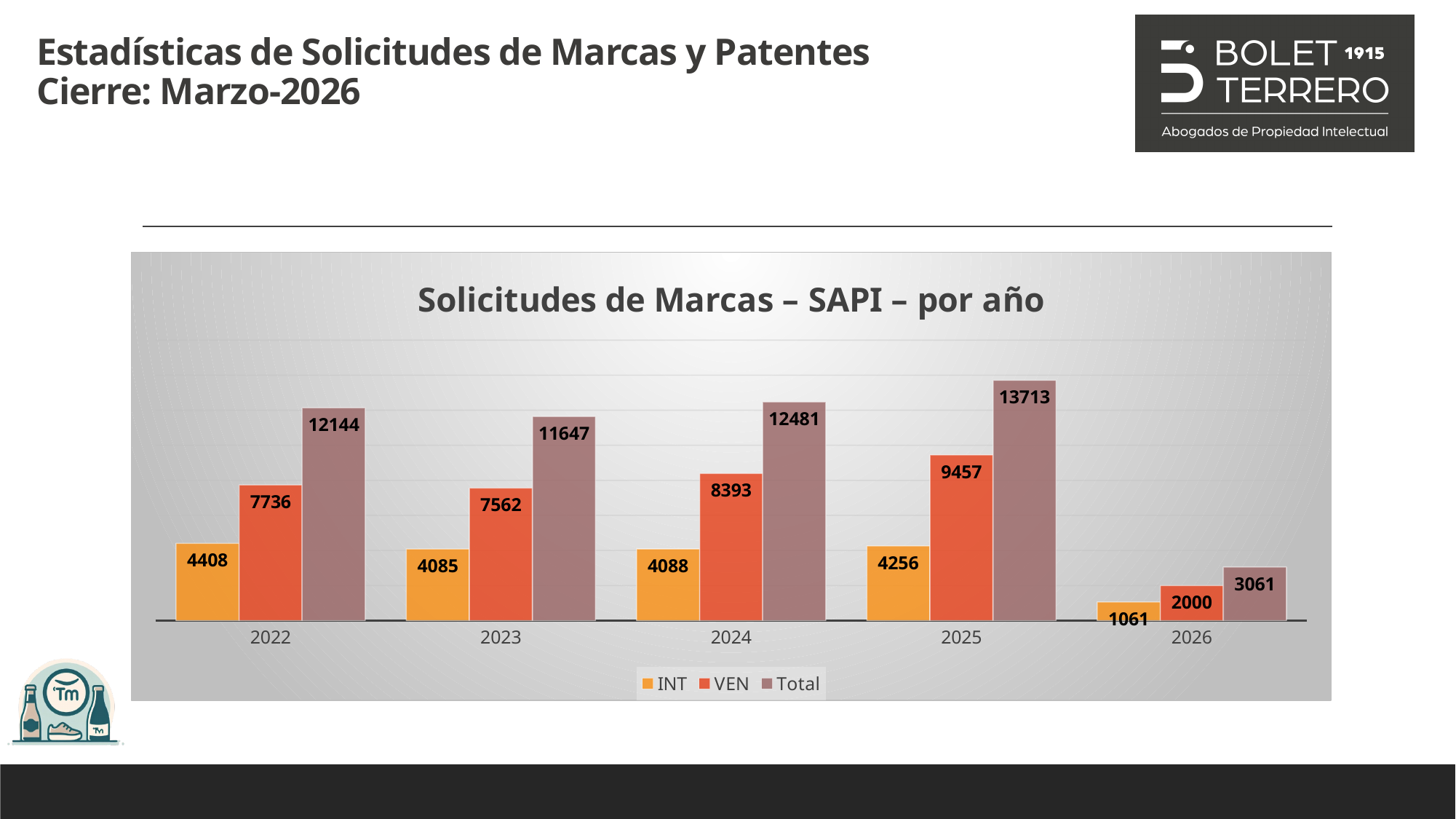
What is the VEN value for 2024? 8393 Which year has the highest Total value? 2025 How many series does the legend list? 3 What is the difference between the VEN values for 2025 and 2024? 1064 What kind of chart is shown on the slide? Bar chart What is the Total value for 2026? 3061 Which year has the lowest INT value? 2026 What is the INT value for 2022? 4408 What is the title of the chart? Solicitudes de Marcas – SAPI – por año Does the Total value rise or fall from 2023 to 2025? Rise How many years are shown on the x axis? 5 Which is larger, the INT value for 2023 or the INT value for 2025? 2025